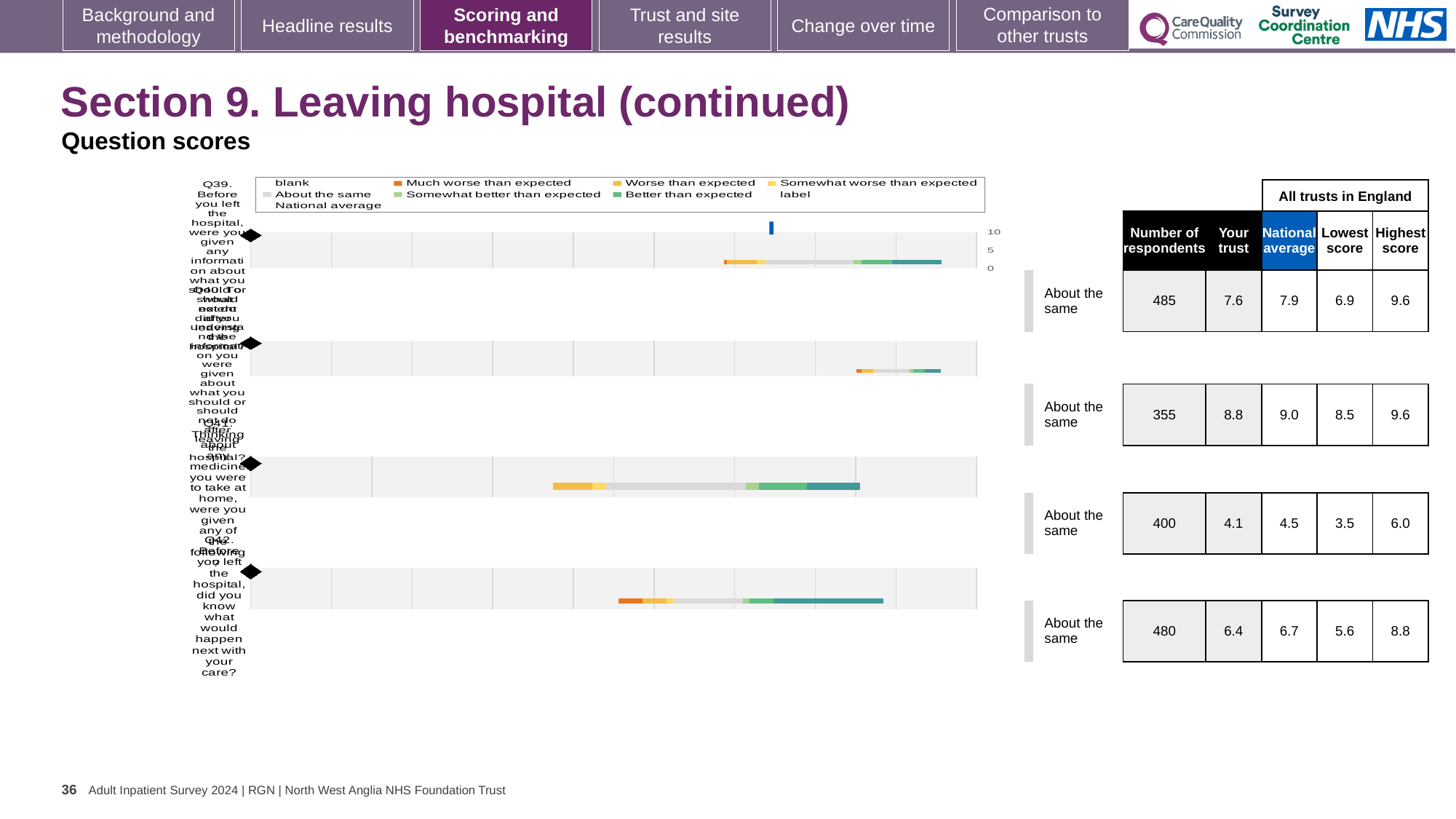
In the table next to the chart, what is the number of respondents for the first row (Q39)? 485 In the table next to the chart, what is the national average for the third row (Q41)? 4.5 In the table next to the chart, which row has the highest 'Your trust' score? the second row (Q40), 8.8 In the table next to the chart, which row has the lowest 'Your trust' score? the third row (Q41), 4.1 For the first row (Q39), which is larger: the 'Your trust' score or the national average? national average In the table next to the chart, what is the 'Your trust' score for the first row (Q39)? 7.6 In the table next to the chart, what is the highest score for the fourth row (Q42)? 8.8 How many survey questions (bars) are plotted in the chart? 4 In the chart legend, what colour is used for 'Much worse than expected'? orange For the first row (Q39), what is the difference between the national average (7.9) and the 'Your trust' score (7.6)? 0.3 What kind of chart is shown on the slide? bar chart